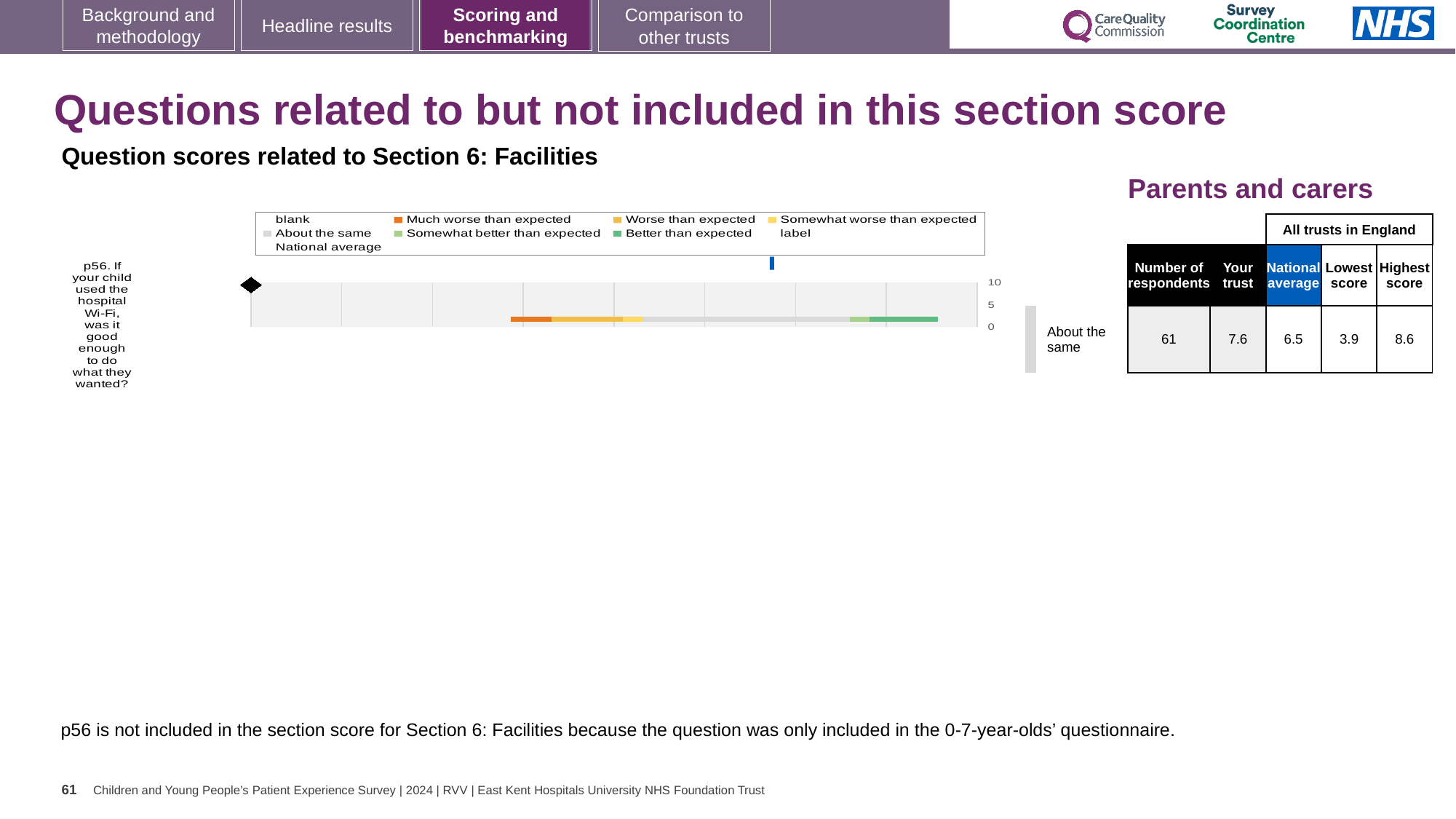
What is the difference between the 'Your trust' score and the national average for p56? 1.1 What is the difference between the highest and lowest scores for p56 across all trusts in England? 4.7 For p56, which is larger: the 'Your trust' score or the national average? Your trust What is the 'Your trust' score for p56? 7.6 How many entries does the chart legend list? 9 What benchmark category label is shown next to the p56 chart? About the same What is the highest score among all trusts in England for p56? 8.6 What is the national average score for p56? 6.5 What is the lowest score among all trusts in England for p56? 3.9 How many questions are plotted in the chart? 1 What is the number of respondents for p56 in the Parents and carers table? 61 What kind of chart is used to show the p56 question score? bar chart